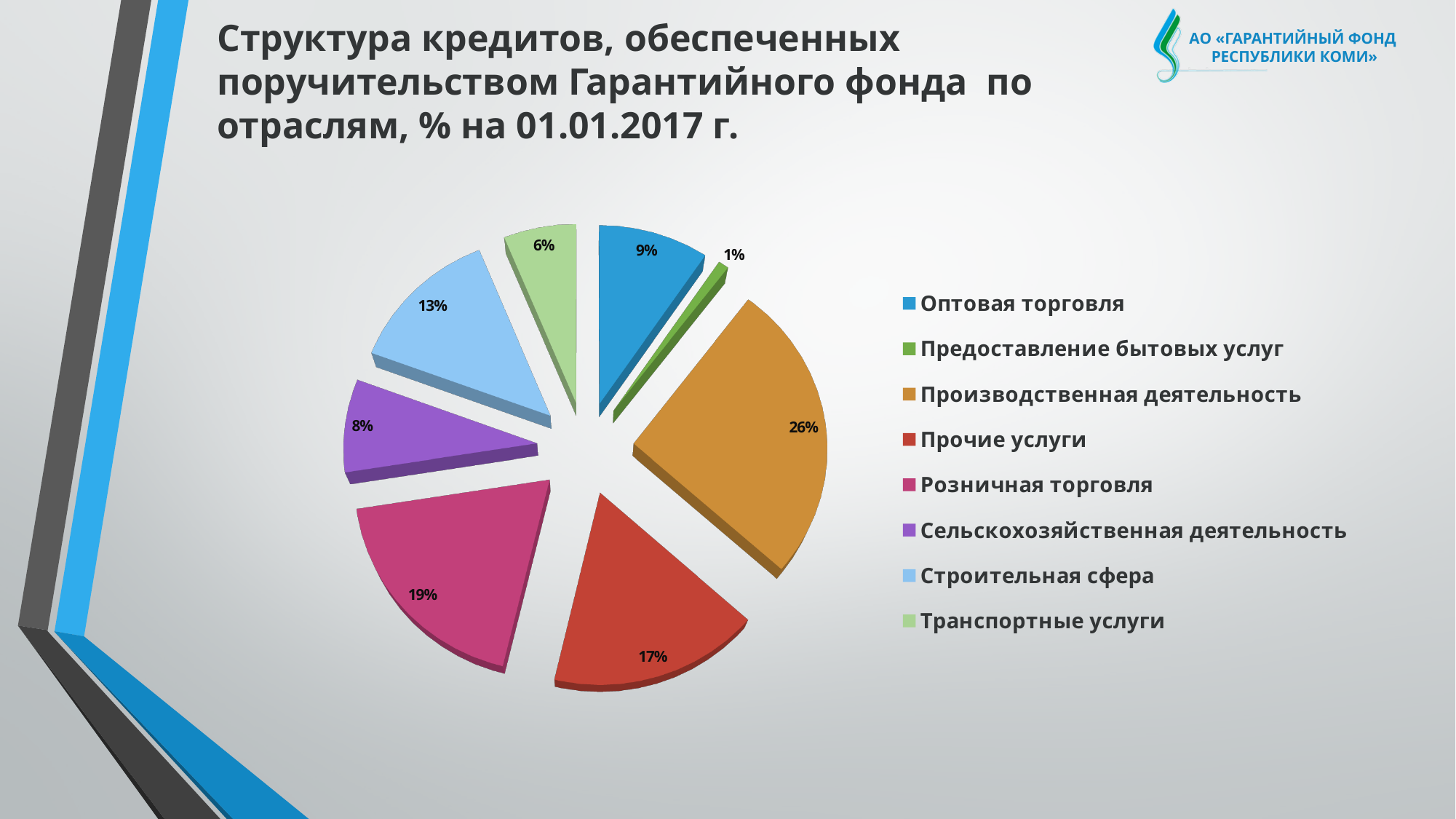
What kind of chart is shown on the slide? Pie chart Which category has the smallest share of the pie? Предоставление бытовых услуг Which is larger, the share for Оптовая торговля or the share for Сельскохозяйственная деятельность? Оптовая торговля What is the difference between the shares of Розничная торговля and Прочие услуги? 2% Which category has the largest share of the pie? Производственная деятельность Which colour represents Прочие услуги in the pie chart? Red What is the value shown for Розничная торговля? 19% What is the difference between the shares of Строительная сфера and Транспортные услуги? 7% What share of the pie does Производственная деятельность have? 26% What is the value shown for Предоставление бытовых услуг? 1% How many categories does the pie chart have? 8 What is the value shown for Строительная сфера? 13%